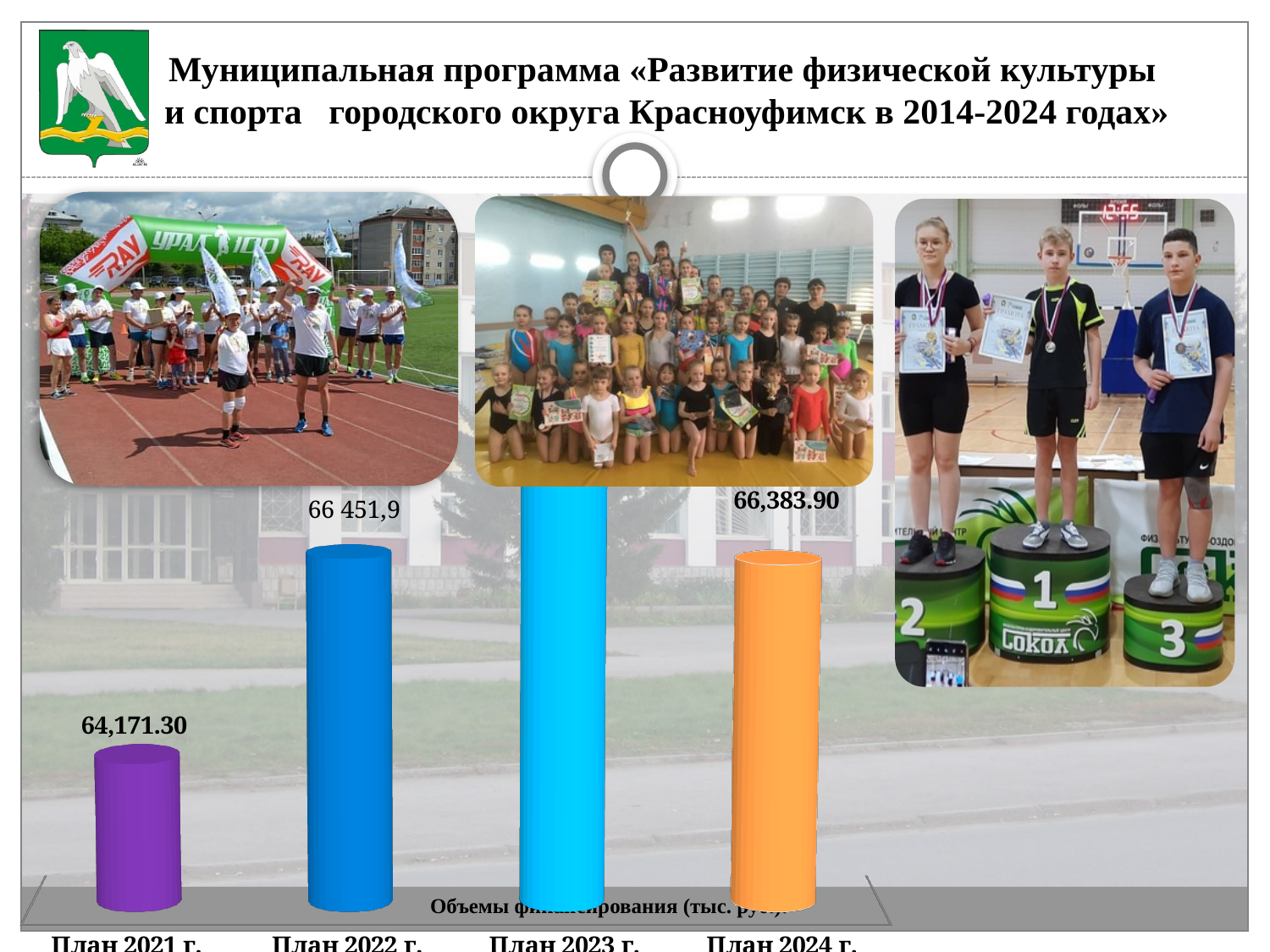
What is the value for План 2021 г.? 64,171.30 Which category has the lowest value? План 2021 г. What colour is the bar for План 2021 г.? purple How many categories are shown on the chart? 4 What is the difference between the values for План 2024 г. and План 2021 г.? 2,212.60 What kind of chart is shown on the slide? bar chart What is the value for План 2022 г.? 66 451,9 Does the value rise or fall from План 2021 г. to План 2022 г.? rise Which category has the tallest bar? План 2023 г. What is the value for План 2024 г.? 66,383.90 Which is larger, the value for План 2021 г. or План 2024 г.? План 2024 г. Which is larger, the value for План 2022 г. or План 2024 г.? План 2022 г.